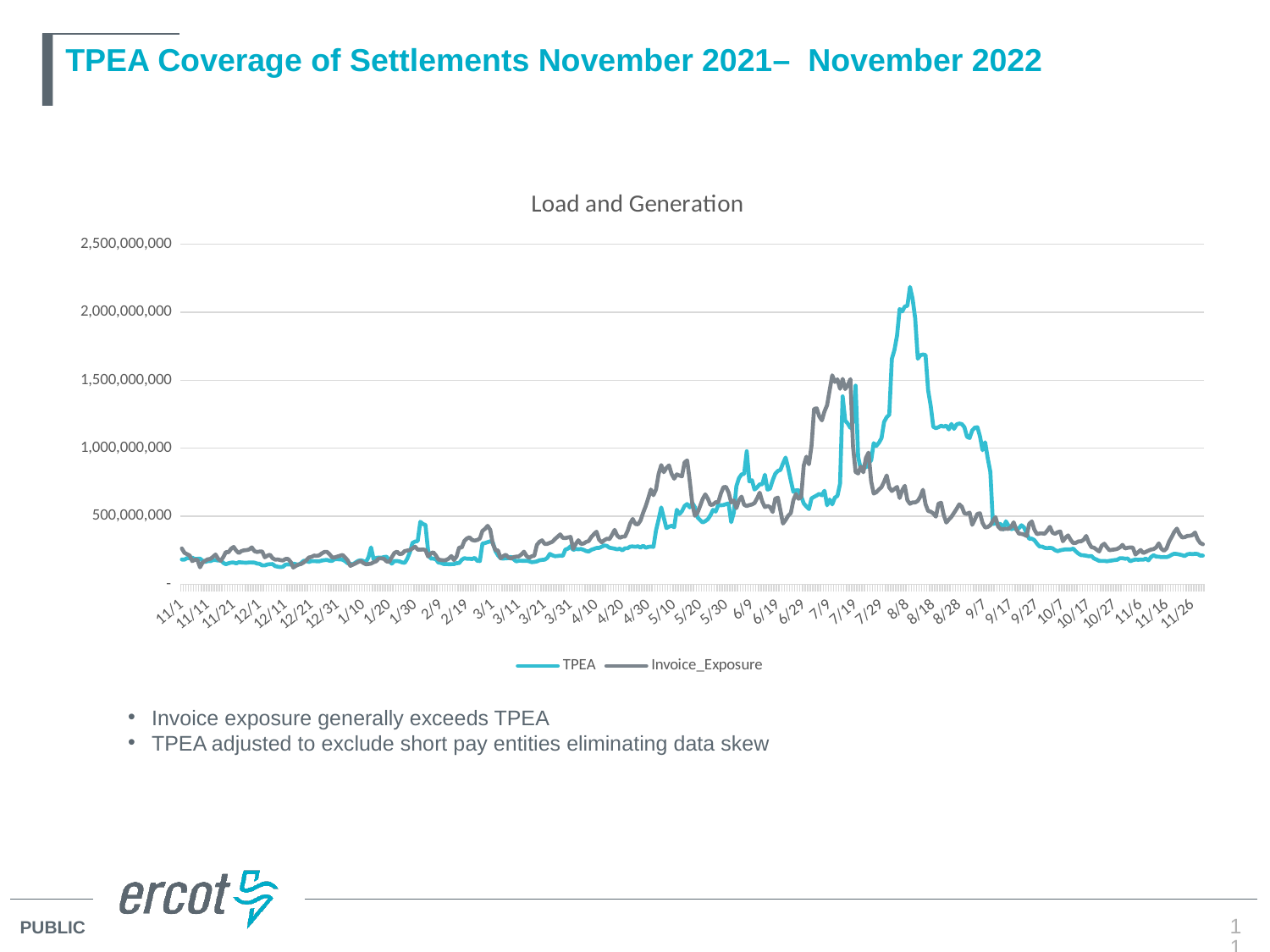
How many series does the legend of the chart list? 2 Does the TPEA line rise or fall from its peak around 8/8 to the end of the chart at 11/26? fall Which series reaches the highest peak on the chart? TPEA Is the peak value of Invoice_Exposure around 7/9 greater or less than 1,000,000,000? greater Is the value of TPEA at 11/1 greater or less than 500,000,000? less Which two series are listed in the chart legend? TPEA and Invoice_Exposure Is the peak value of TPEA around 8/8 greater or less than 2,000,000,000? greater What is the title of the chart? Load and Generation Around 8/8, which series has the larger value, TPEA or Invoice_Exposure? TPEA Around 7/9, which series has the larger value, TPEA or Invoice_Exposure? Invoice_Exposure What is the highest value labelled on the vertical axis? 2,500,000,000 What kind of chart is shown on the slide? Line chart